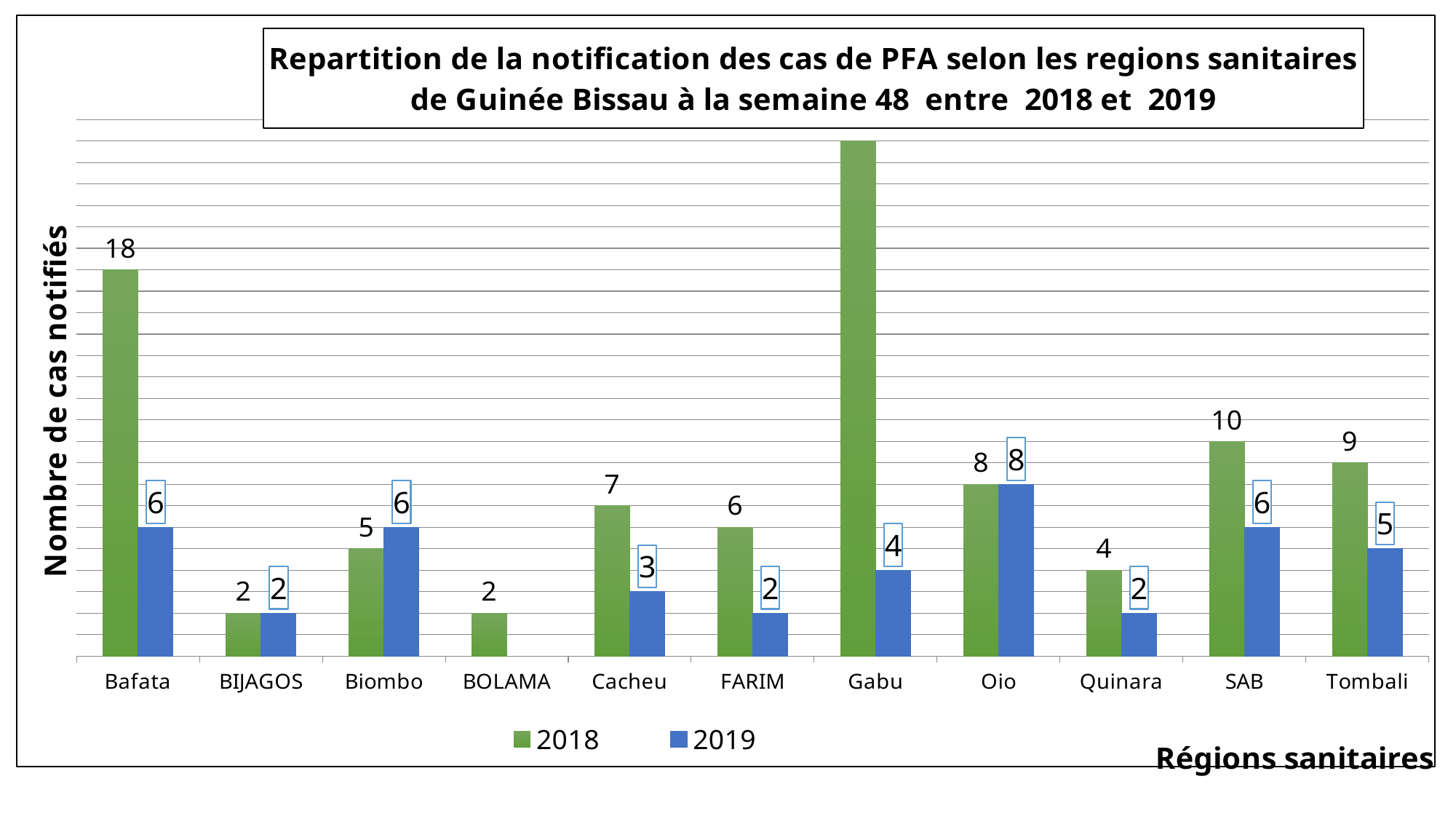
What is the 2018 value for SAB? 10 How many series does the legend list? 2 Which region has the highest 2018 value? Gabu What is the 2019 value for Cacheu? 3 Which region has the highest 2019 value? Oio What kind of chart is shown on the slide? bar chart Which is larger for Biombo, the 2018 value or the 2019 value? 2019 What is the difference between the 2018 and 2019 values for Bafata? 12 How many regions are shown on the x axis? 11 What is the 2019 value for Tombali? 5 What is the difference between the 2018 values for SAB and Tombali? 1 What is the 2018 value for Bafata? 18